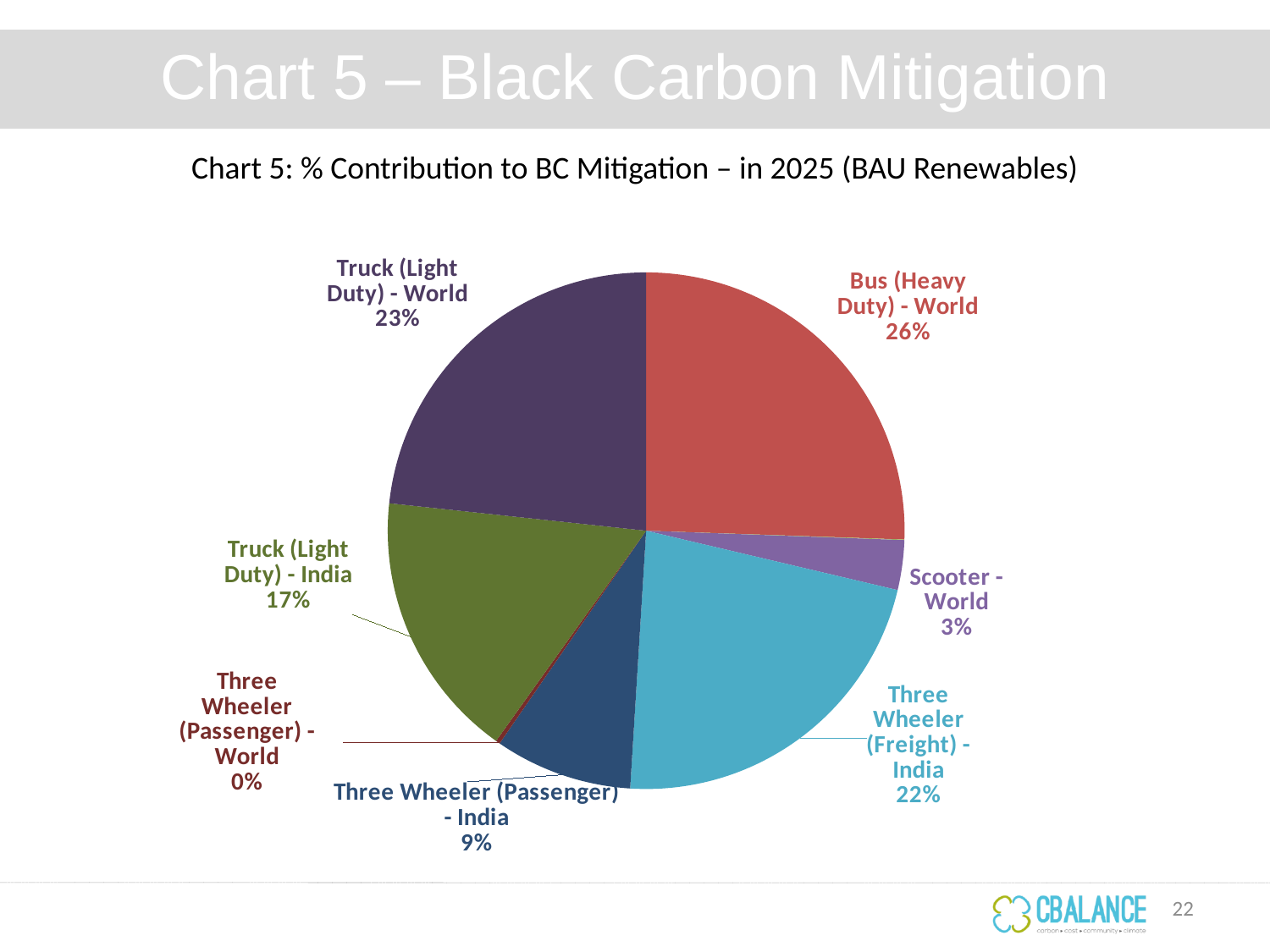
What is the percentage contribution of Three Wheeler (Freight) - India? 22% What is the combined share of Bus (Heavy Duty) - World and Truck (Light Duty) - World? 49% What is the percentage contribution of Scooter - World? 3% Which has a larger share: Three Wheeler (Freight) - India or Three Wheeler (Passenger) - India? Three Wheeler (Freight) - India Which category has the largest share of the pie? Bus (Heavy Duty) - World What is the difference in percentage points between Truck (Light Duty) - World and Truck (Light Duty) - India? 6 What kind of chart is shown on the slide? Pie chart What is the percentage contribution of Truck (Light Duty) - India? 17% What colour is the Bus (Heavy Duty) - World slice? Red What is the percentage contribution of Bus (Heavy Duty) - World? 26% What is the title of the chart? Chart 5: % Contribution to BC Mitigation – in 2025 (BAU Renewables) Which labelled category has the smallest share of the pie? Three Wheeler (Passenger) - World